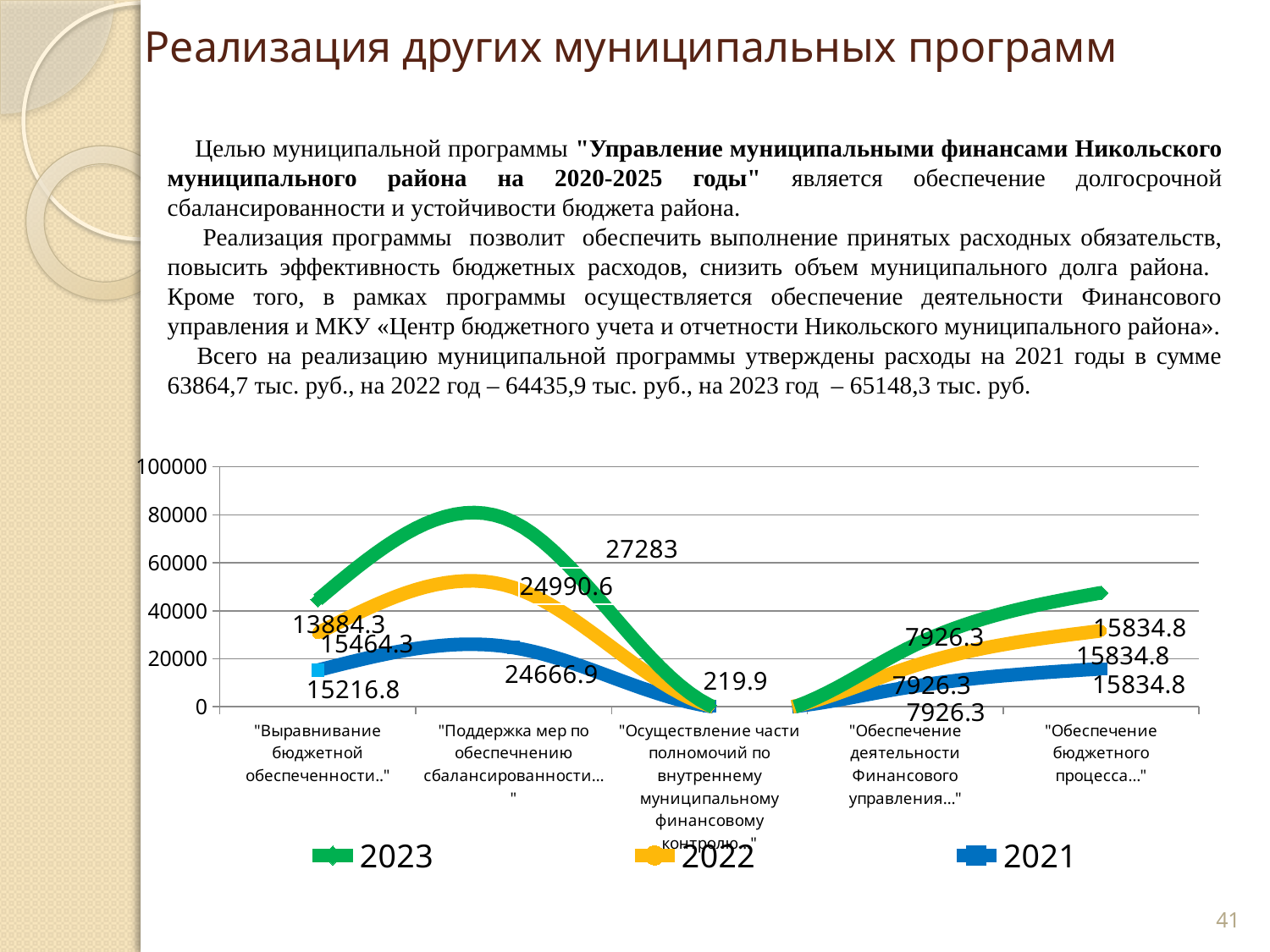
What value is labelled for the category "Обеспечение деятельности Финансового управления..." in each of the three years? 7926.3 What value is labelled for the category "Обеспечение бюджетного процесса..." in each of the three years? 15834.8 What is the 2022 value for the category "Поддержка мер по обеспечению сбалансированности..."? 24990.6 What kind of chart is shown on the slide? line chart How many series does the chart legend list? 3 Which years are listed in the chart legend? 2023, 2022, 2021 What is the 2023 value for the category "Поддержка мер по обеспечению сбалансированности..."? 27283 For "Поддержка мер по обеспечению сбалансированности...", which is larger: the 2022 value or the 2021 value? 2022 What is the difference between the 2023 and 2022 values for "Поддержка мер по обеспечению сбалансированности..."? 2292.4 How many categories are shown along the x axis of the chart? 5 Which colour represents the 2021 series in the chart? blue What is the 2021 value for the category "Поддержка мер по обеспечению сбалансированности..."? 24666.9